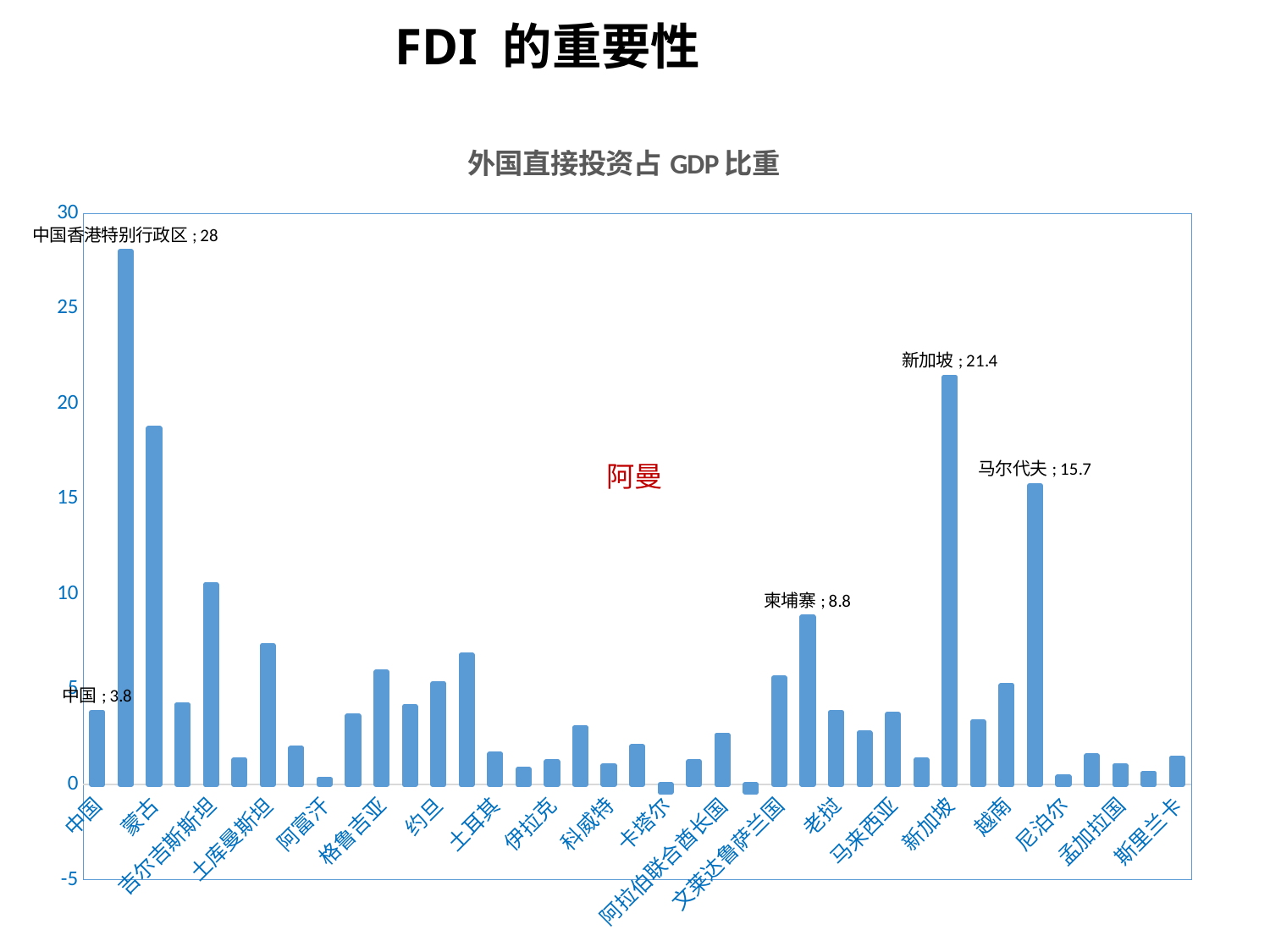
What is the value for 中国 in the chart? 3.8 What is the value for 中国香港特别行政区 in the chart? 28 Which category has the highest value in the chart? 中国香港特别行政区 Is the value for 蒙古 greater or less than 15? greater What is the difference between the values for 中国香港特别行政区 and 新加坡? 6.6 Is the value for 卡塔尔 greater or less than 0? less What is the value for 马尔代夫 in the chart? 15.7 Which is larger, the value for 柬埔寨 or the value for 中国? 柬埔寨 What kind of chart is shown on the slide? bar chart What is the difference between the values for 新加坡 and 马尔代夫? 5.7 What is the value for 柬埔寨 in the chart? 8.8 What is the value for 新加坡 in the chart? 21.4